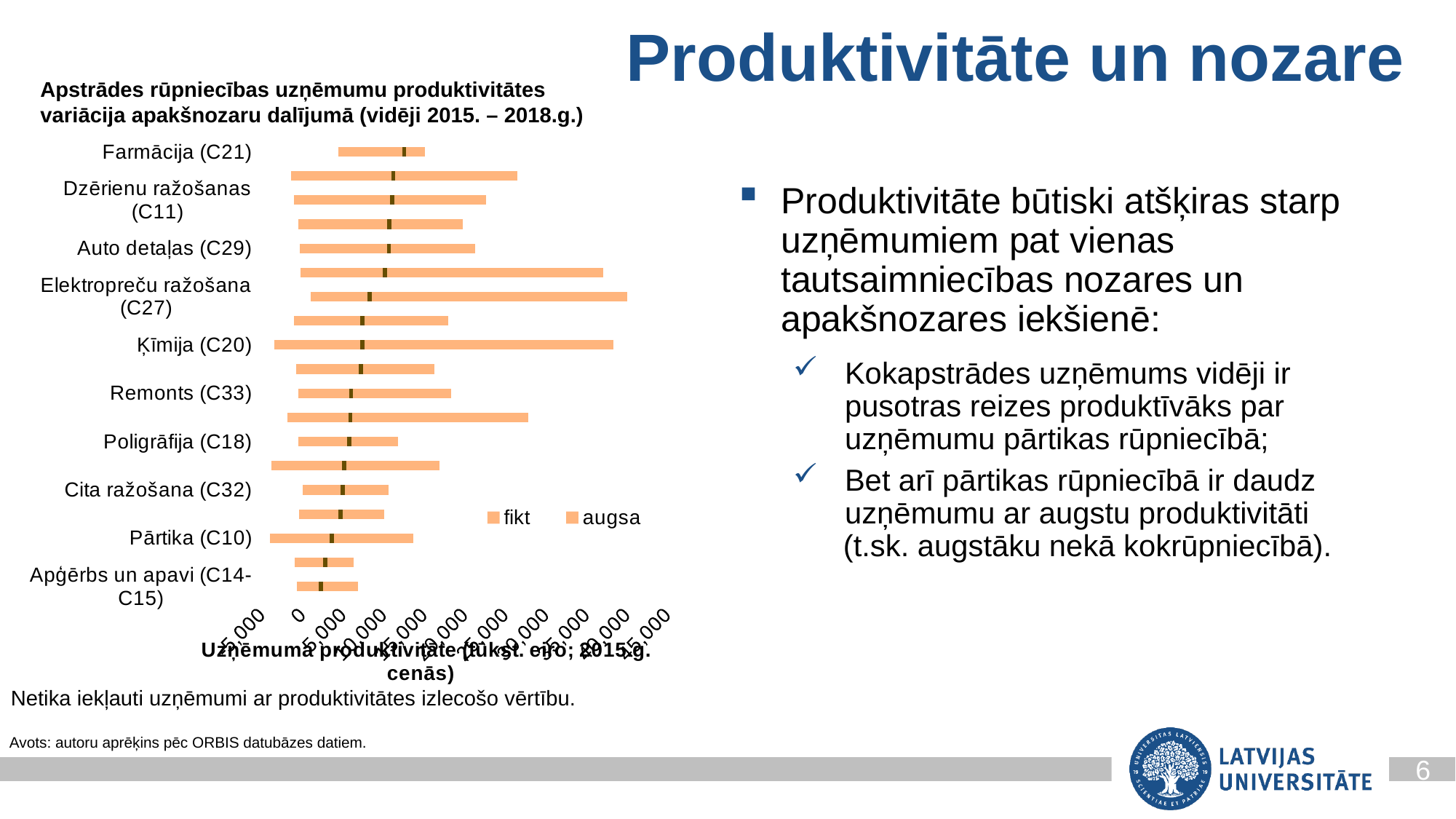
How many entries does the chart legend list? 2 What are the two entries in the chart legend? fikt, augsa Which labelled category has the shortest bar in the chart? Apģērbs un apavi (C14-C15) Which bar extends further to the right: Elektropreču ražošana (C27) or Apģērbs un apavi (C14-C15)? Elektropreču ražošana (C27) Is the right end of the bar for Apģērbs un apavi (C14-C15) greater or less than 10,000? less What is the title of the chart? Apstrādes rūpniecības uzņēmumu produktivitātes variācija apakšnozaru dalījumā (vidēji 2015. – 2018.g.) How many sub-sector categories are labelled on the vertical axis of the chart? 10 What is the highest tick value shown on the horizontal axis of the chart? 45,000 Is the left end of the bar for Farmācija (C21) greater or less than 0? greater Is the right end of the bar for Elektropreču ražošana (C27) greater or less than 35,000? greater What kind of chart is shown on the slide? bar chart What is the lowest tick value shown on the horizontal axis of the chart? -5,000